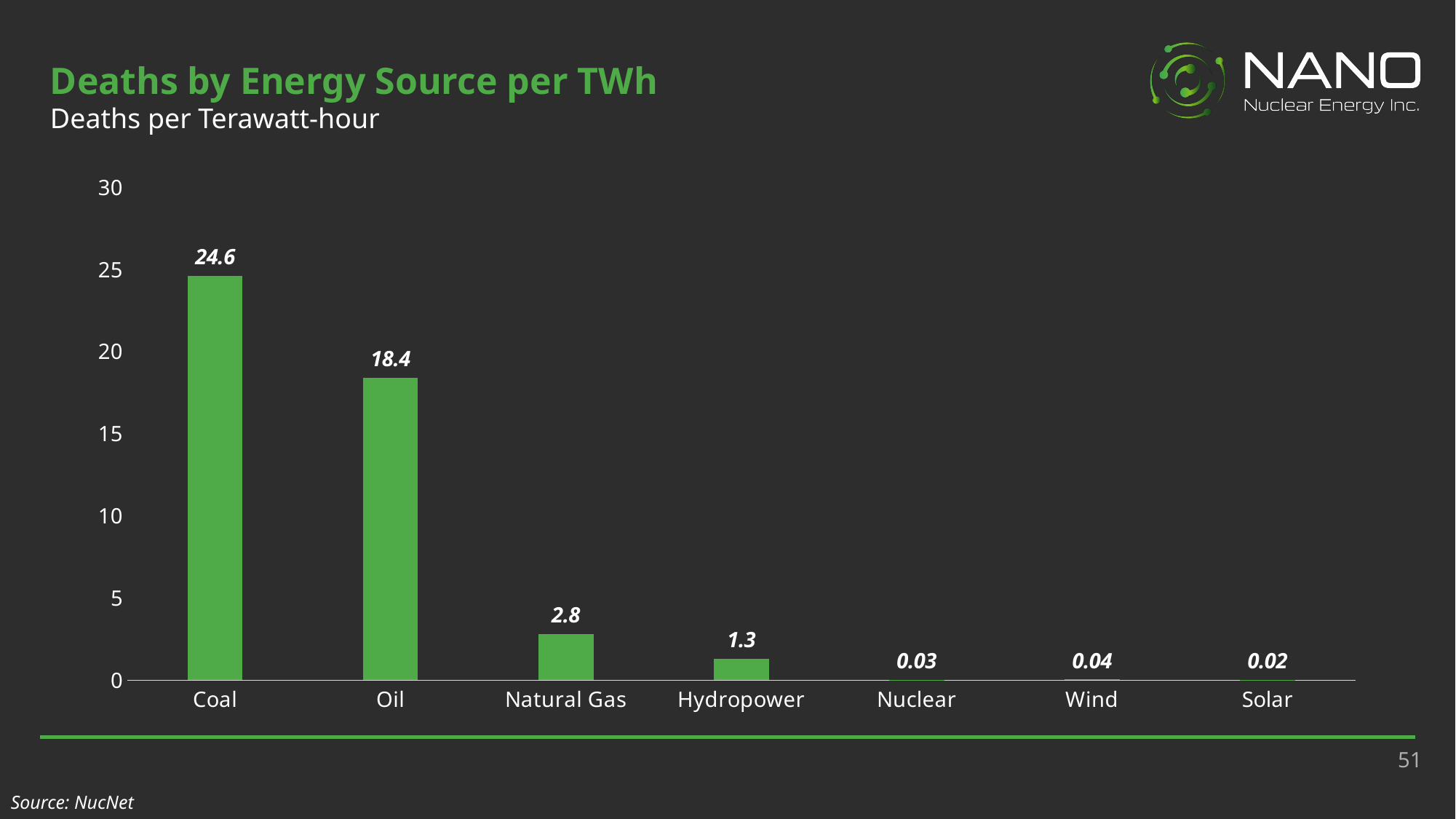
Which has a higher value, Natural Gas or Hydropower? Natural Gas What is the title of the chart? Deaths by Energy Source per TWh What is the value for Hydropower? 1.3 What is the value for Nuclear? 0.03 What is the value for Coal? 24.6 What is the value for Natural Gas? 2.8 Which energy source has the lowest deaths per TWh? Solar Which energy source has the highest deaths per TWh? Coal What is the value for Oil? 18.4 What is the difference between the values for Coal and Oil? 6.2 How many energy sources are shown on the chart? 7 What kind of chart is shown on the slide? Bar chart